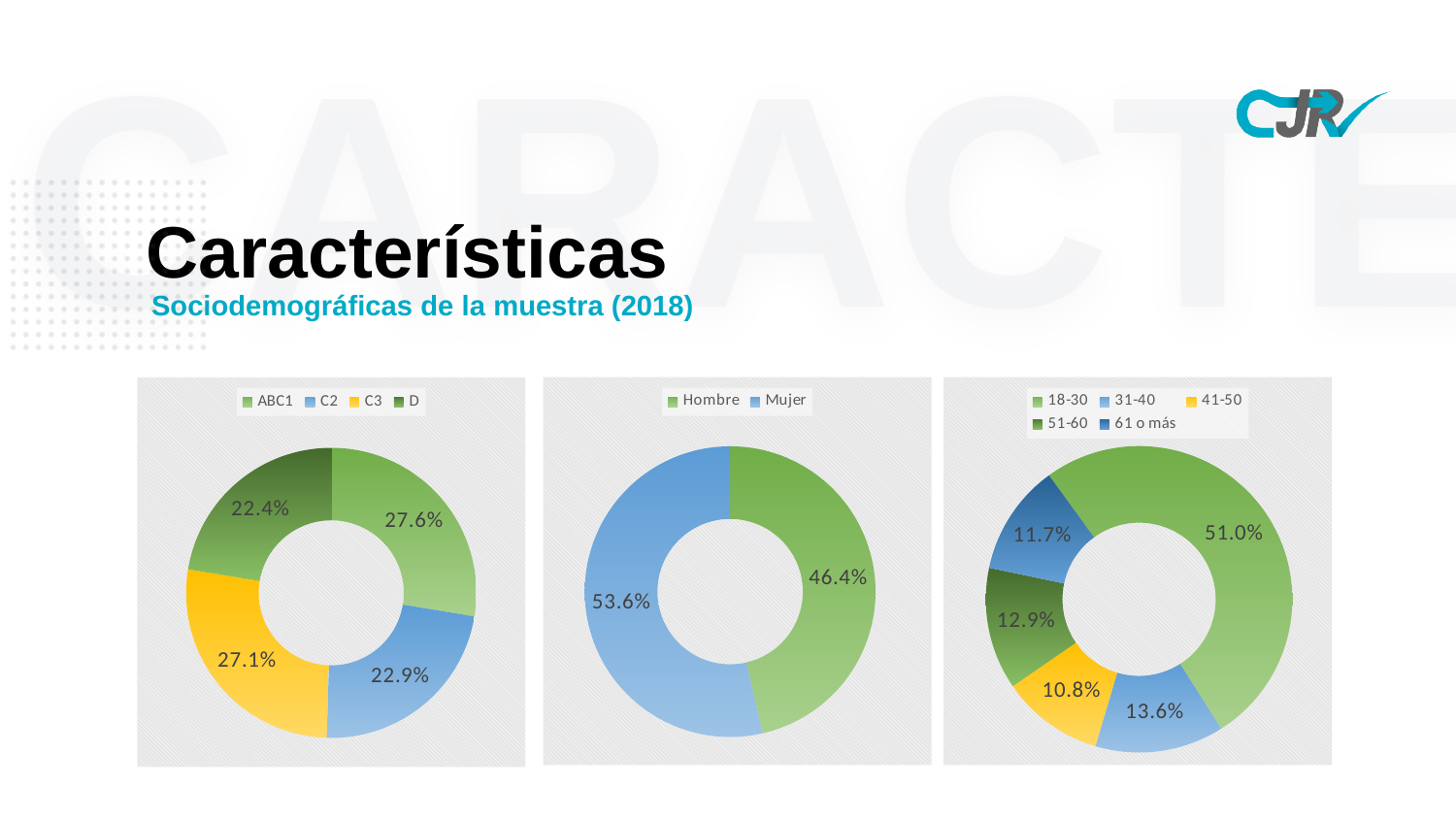
In the middle chart, which is larger, Hombre or Mujer? Mujer In the right chart, what is the value for 18-30? 51.0% How many categories does the right chart show? 5 In the right chart, what is the value for 41-50? 10.8% In the right chart, which age group has the largest share? 18-30 In the left chart, what is the value for C3? 27.1% What kind of chart is the left chart? Doughnut chart In the left chart, what is the difference between the ABC1 and C2 values? 4.7% How many series does the legend of the middle chart list? 2 In the left chart, what share does ABC1 have? 27.6% In the left chart, which category has the smallest share? D In the middle chart, what is the value for Mujer? 53.6%